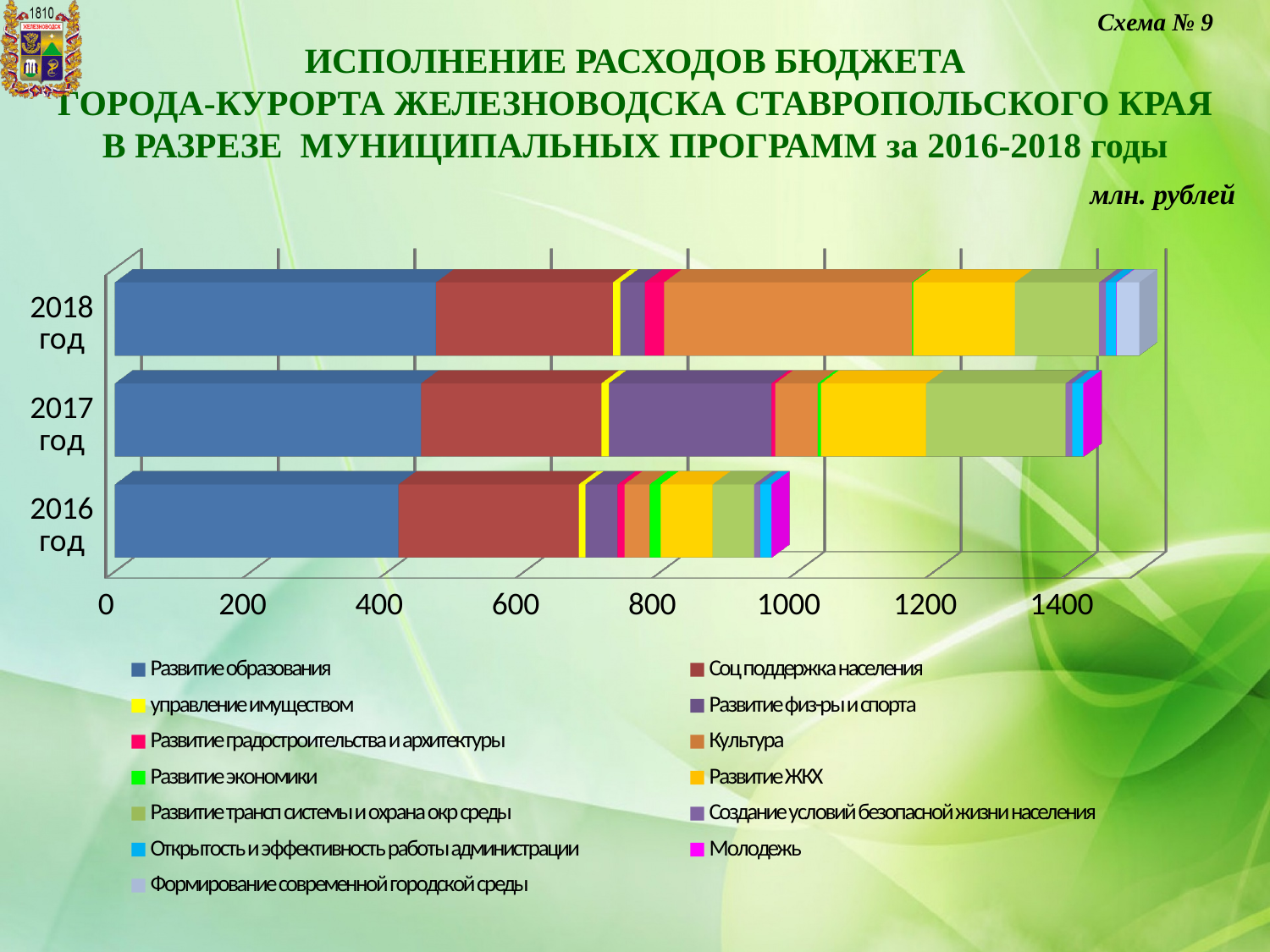
Is the total bar for 2018 год greater or less than 1400? greater Is the total bar for 2016 год greater or less than 800? greater Is the total bar for 2017 год greater or less than 1200? greater Which total bar is longer, 2018 год or 2017 год? 2018 год How many years (categories) are plotted on the chart? 3 What unit of measurement is stated for the chart? млн. рублей Which year has the longest total bar? 2018 год Do the total bar lengths rise or fall from 2016 год to 2018 год? rise How many series does the legend list? 13 Which year has the shortest total bar? 2016 год What kind of chart is shown on the slide? Stacked bar chart Which series is shown in blue as the first segment of each bar? Развитие образования